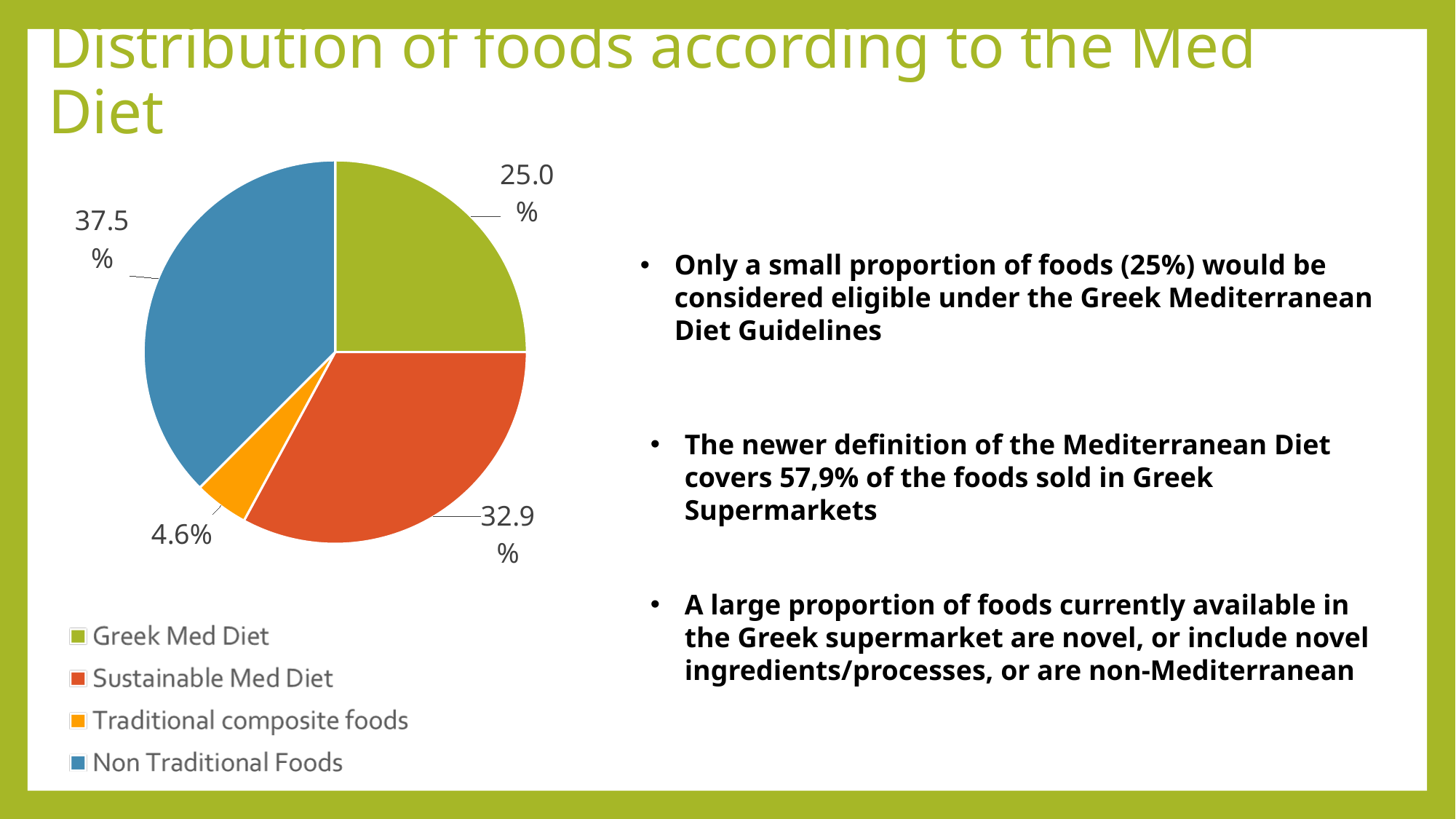
What share of the pie does Greek Med Diet represent? 25.0% What share of the pie does Non Traditional Foods represent? 37.5% Which category has the smallest slice of the pie? Traditional composite foods What share of the pie does Traditional composite foods represent? 4.6% What is the difference in percentage points between Non Traditional Foods and Greek Med Diet? 12.5 Which category has the largest slice of the pie? Non Traditional Foods What share of the pie does Sustainable Med Diet represent? 32.9% Which is larger, the slice for Sustainable Med Diet or the slice for Greek Med Diet? Sustainable Med Diet What kind of chart is shown on the slide? pie chart What colour is the slice for Non Traditional Foods? blue How many slices does the pie chart have? 4 Which legend entry is shown in orange? Traditional composite foods